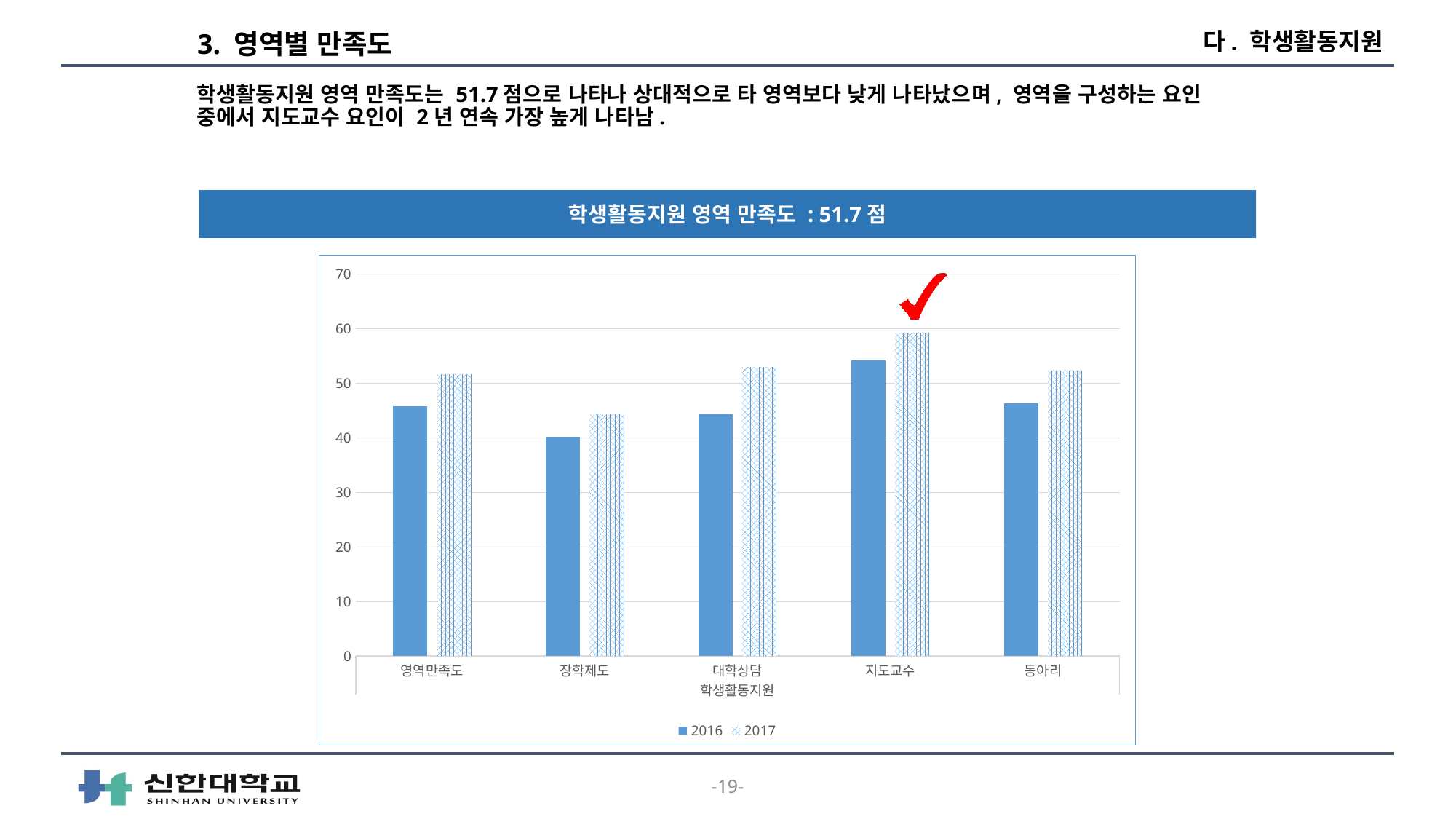
Is the 2017 value for 동아리 greater or less than 50? greater Is the 2016 value for 지도교수 greater or less than 50? greater How many categories are shown on the x axis of the chart? 5 Which category has the lowest value for the 2016 series? 장학제도 Is the 2016 value for 대학상담 greater or less than 50? less Which two series are listed in the chart legend? 2016 and 2017 What kind of chart is shown on the slide? bar chart Which category has the highest value for the 2016 series? 지도교수 Which category has the lowest value for the 2017 series? 장학제도 How many series does the chart legend list? 2 For 대학상담, which series has the larger value, 2016 or 2017? 2017 Which category has the highest value for the 2017 series? 지도교수